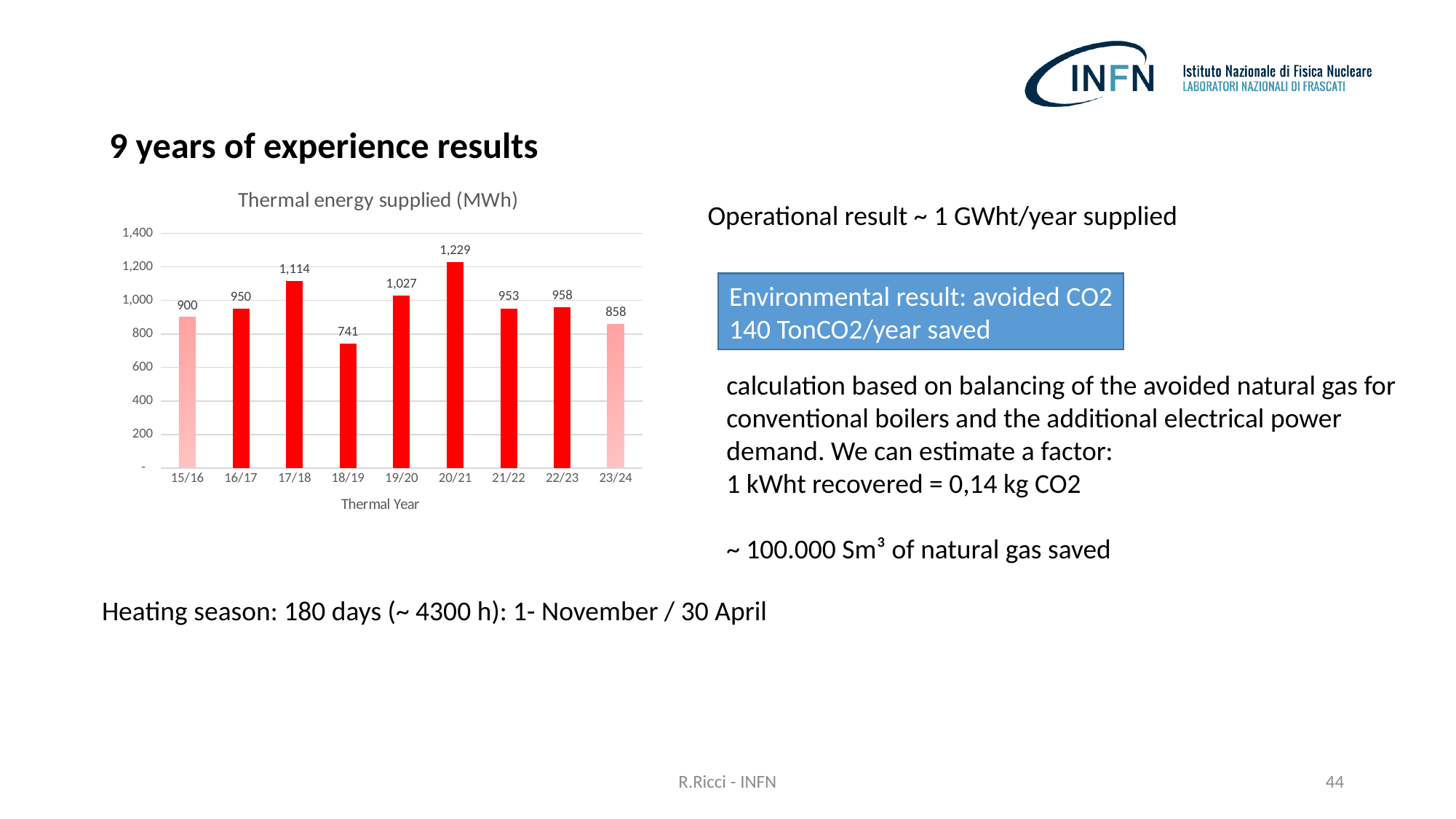
What is the difference in thermal energy supplied between 16/17 and 15/16? 50 What is the thermal energy supplied in thermal year 17/18? 1,114 What is the thermal energy supplied in thermal year 23/24? 858 Is the value for 18/19 greater or less than 800? less What is the thermal energy supplied in thermal year 19/20? 1,027 What is the title of the chart? Thermal energy supplied (MWh) Which thermal year has a larger value, 17/18 or 19/20? 17/18 How many thermal years are shown on the x axis of the chart? 9 What is the difference in thermal energy supplied between 20/21 and 18/19? 488 What kind of chart is used to show thermal energy supplied? bar chart Which thermal year has the lowest thermal energy supplied? 18/19 Which thermal year has the highest thermal energy supplied? 20/21